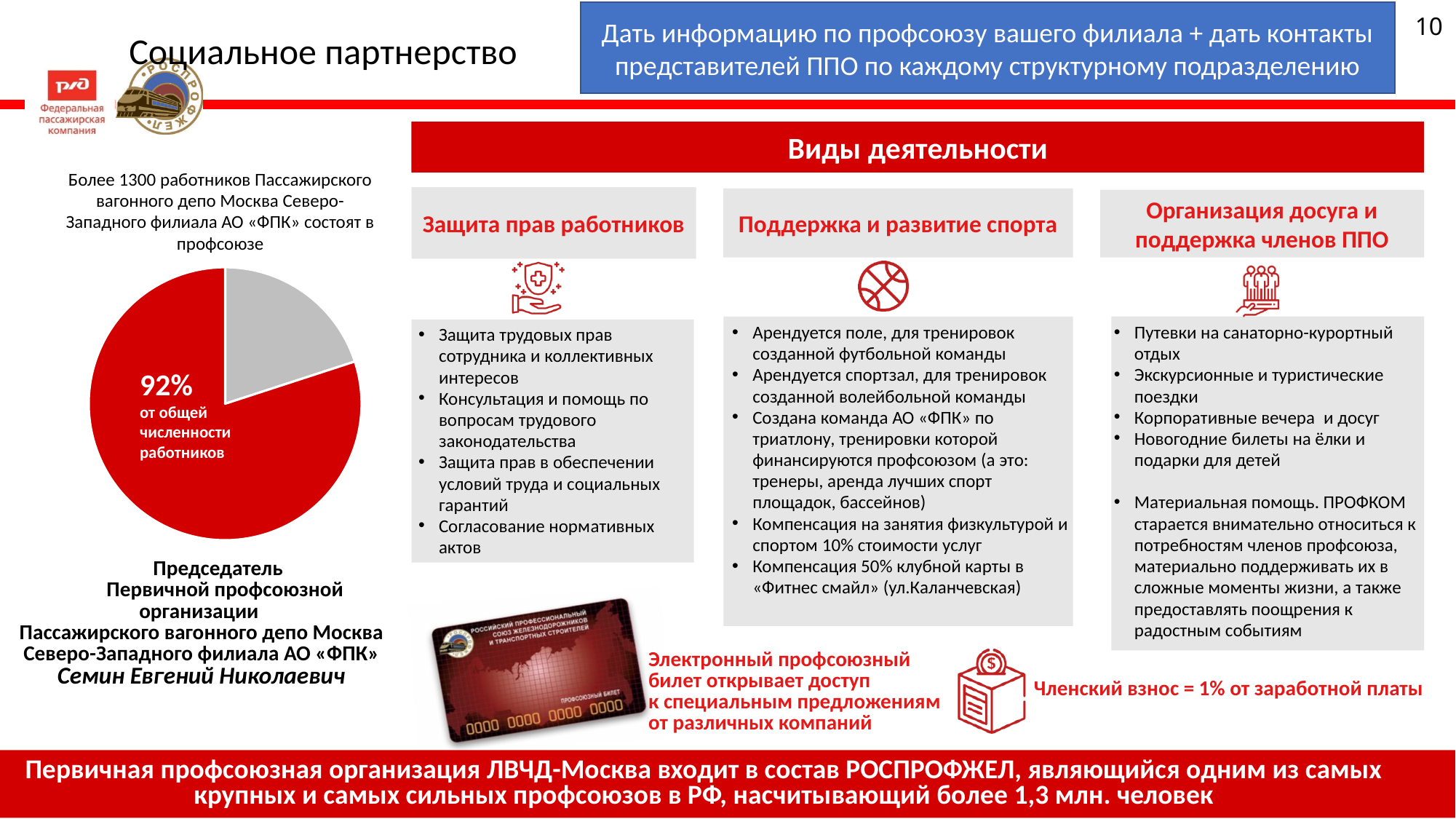
What share of the total workforce does the red slice of the pie chart represent? 92% How many slices does the pie chart have? 2 Which slice of the pie chart is larger, the red one or the grey one? the red one Is the share shown by the grey slice of the pie chart greater or less than 50%? less According to the label inside the pie chart, 92% is a share of what? от общей численности работников What kind of chart is shown on the left of the slide? pie chart Is the share shown by the red slice of the pie chart greater or less than 50%? greater What colour is the slice of the pie chart labelled 92%? red